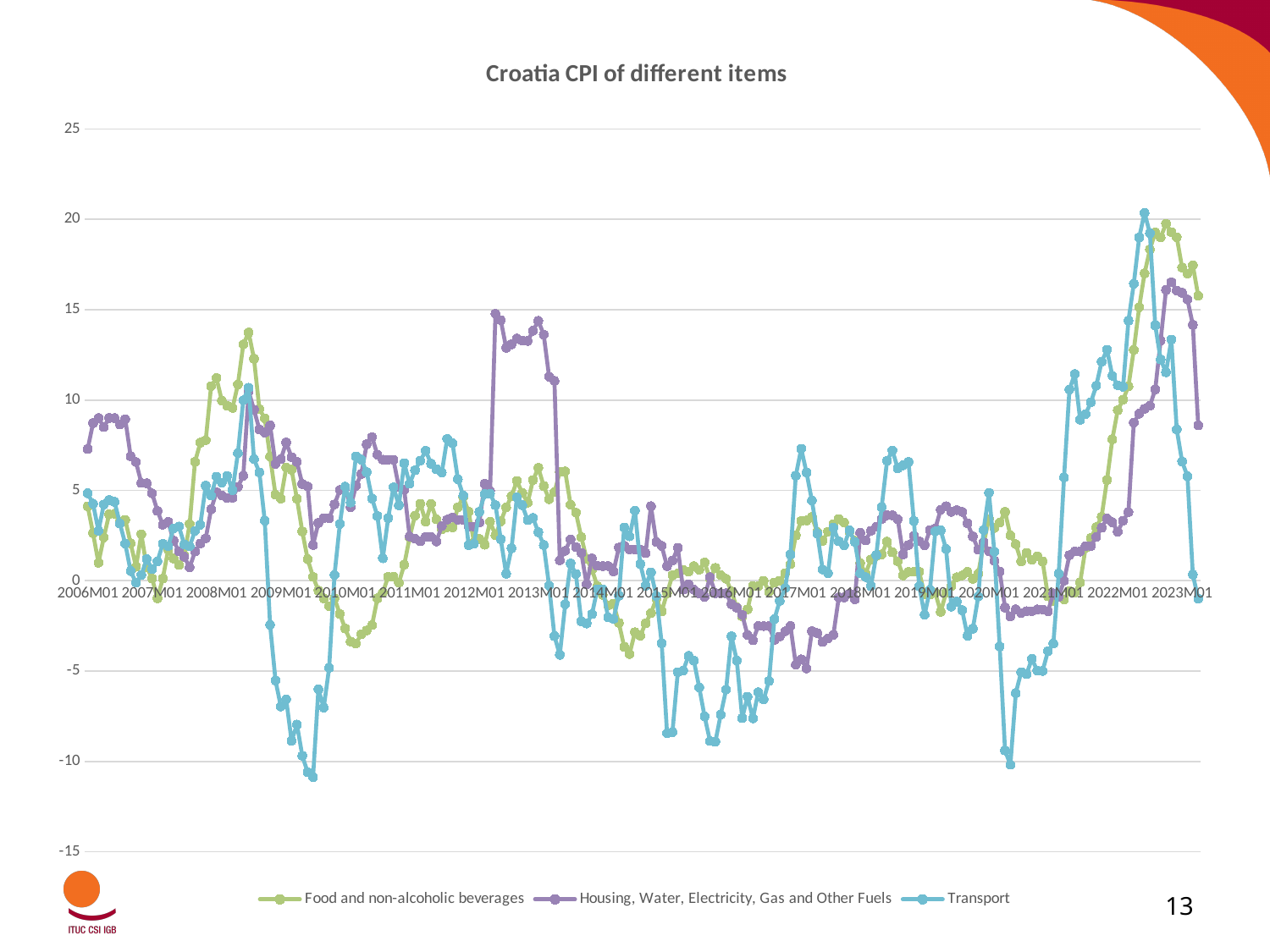
Which series reaches the lowest value anywhere on the chart? Transport What kind of chart is shown on the slide? Line chart Is the lowest value of the Transport series around 2009 greater or less than -10? less Is the peak of the Transport series around 2022 greater or less than 15? greater How many year labels are shown along the x axis? 18 What is the title of the chart? Croatia CPI of different items Between 2012M01 and 2013M01, which series has the higher values: Housing, Water, Electricity, Gas and Other Fuels or Food and non-alcoholic beverages? Housing, Water, Electricity, Gas and Other Fuels What is the highest value shown on the vertical axis? 25 How many series does the legend list? 3 Is the peak of the Food and non-alcoholic beverages series around 2023M01 greater or less than 15? greater Does the Food and non-alcoholic beverages series rise or fall between 2022M01 and 2023M01? Rise